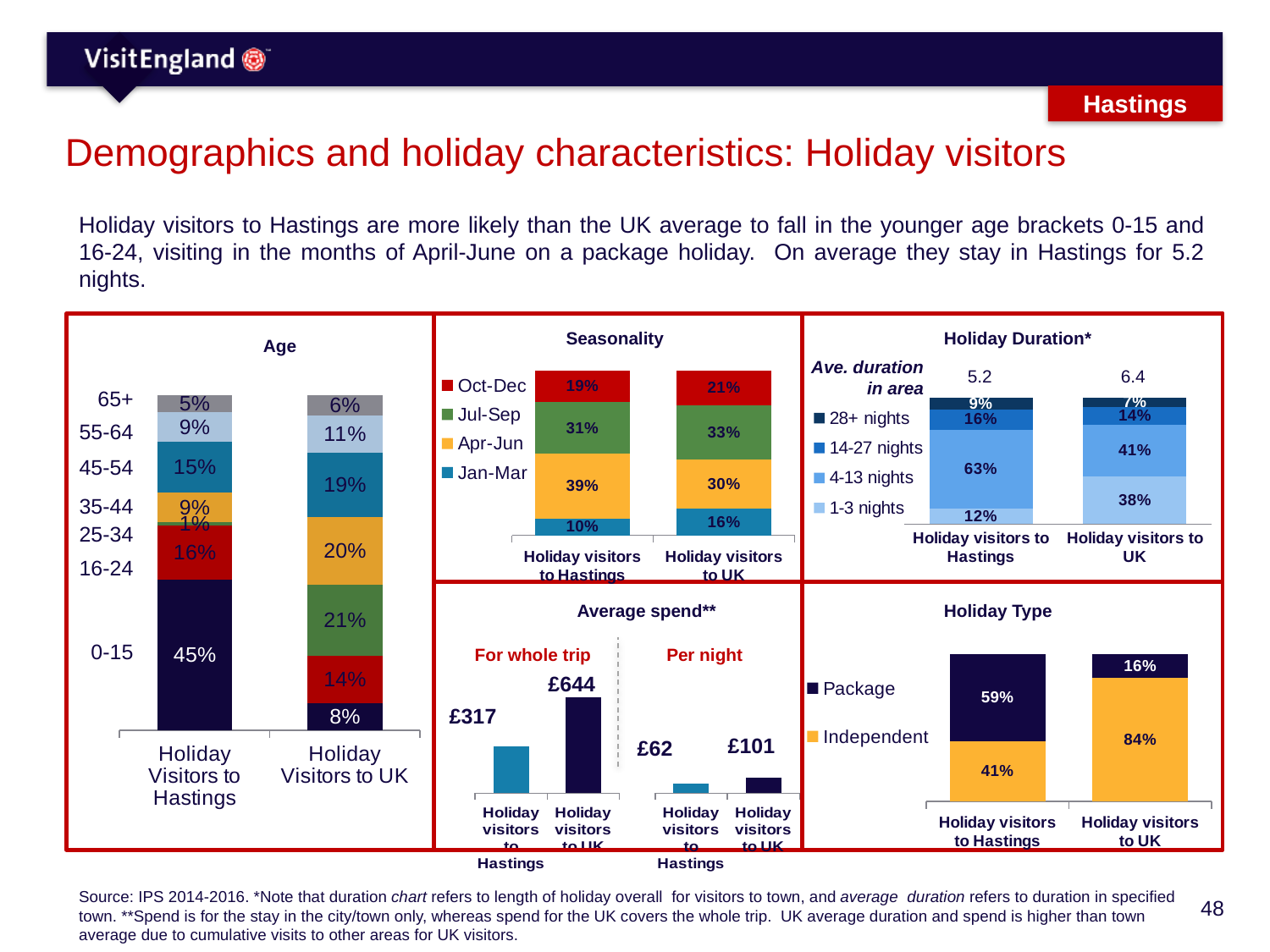
In the Age chart, what percentage of holiday visitors to the UK are aged 25-34? 21% What kind of chart is the Holiday Type chart? Stacked bar chart In the Seasonality chart, what share of holiday visitors to Hastings visit in Apr-Jun? 39% In the Holiday Type chart, what percentage of holiday visitors to Hastings are on a package holiday? 59% In the Holiday Duration chart, what percentage of holiday visitors to Hastings stay 4-13 nights? 63% In the Average spend chart, what is the difference in per night spend between holiday visitors to the UK and holiday visitors to Hastings? £39 In the Holiday Type chart, which is larger for holiday visitors to the UK: Package or Independent? Independent In the Holiday Duration chart, what is the average duration in area for holiday visitors to Hastings? 5.2 In the Seasonality chart, which quarter has the lowest share of holiday visitors to Hastings? Jan-Mar In the Seasonality chart, how many series does the legend list? 4 In the Age chart, what percentage of holiday visitors to Hastings are aged 0-15? 45% In the Average spend chart, what is the spend for the whole trip for holiday visitors to the UK? £644